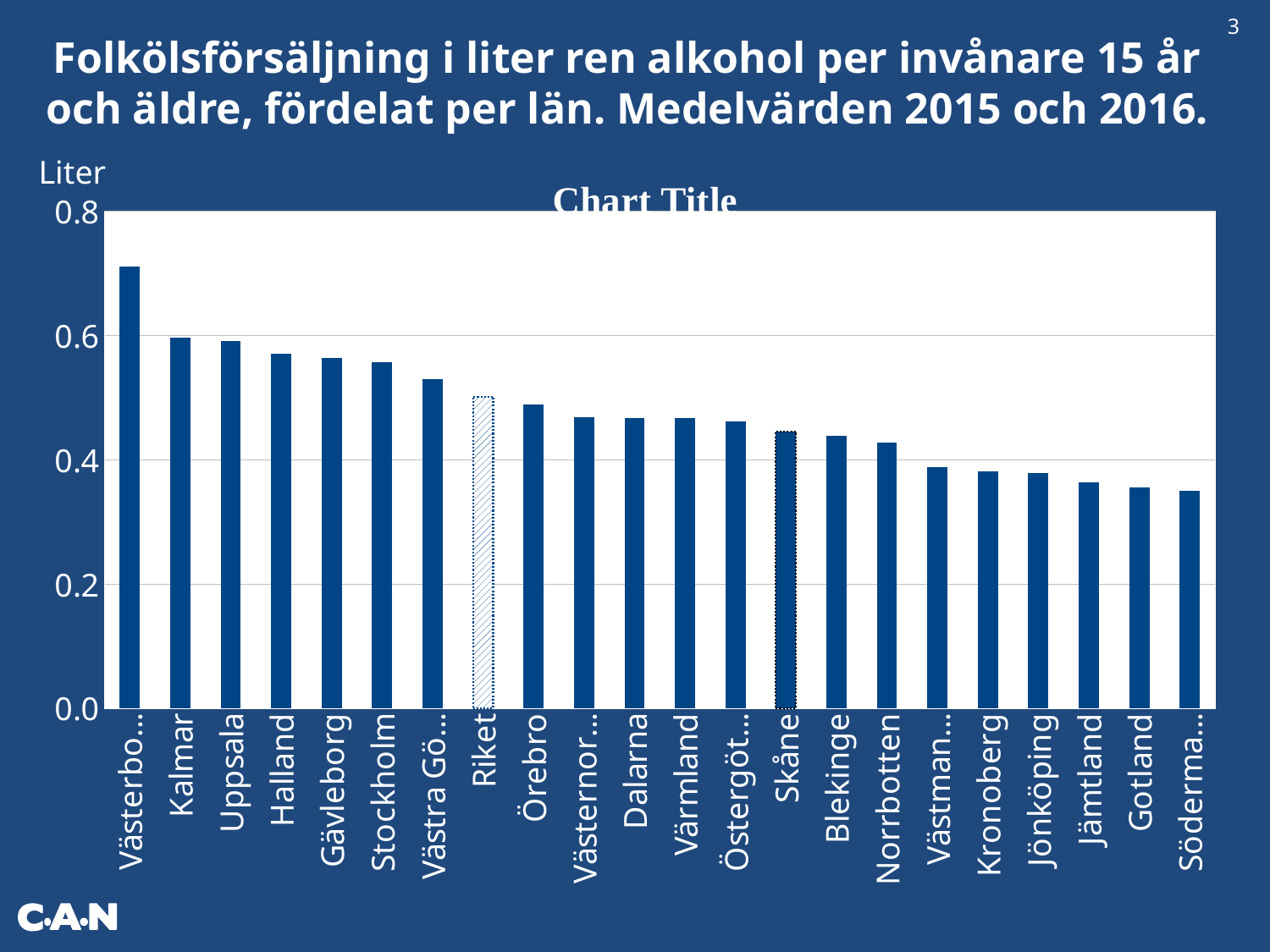
Is the value for Halland greater or less than 0.6? less Which has the larger value, Stockholm or Skåne? Stockholm Is the value for Kronoberg greater or less than 0.4? less Do the values rise or fall moving from left to right along the x axis? fall Is the value for Gotland greater or less than 0.4? less How many bars (län plus Riket) are plotted in the chart? 22 What kind of chart is shown on the slide? bar chart Which bar is drawn with a hatched pattern instead of solid fill? Riket What unit is shown above the y axis? Liter Which has the larger value, Kalmar or Gotland? Kalmar